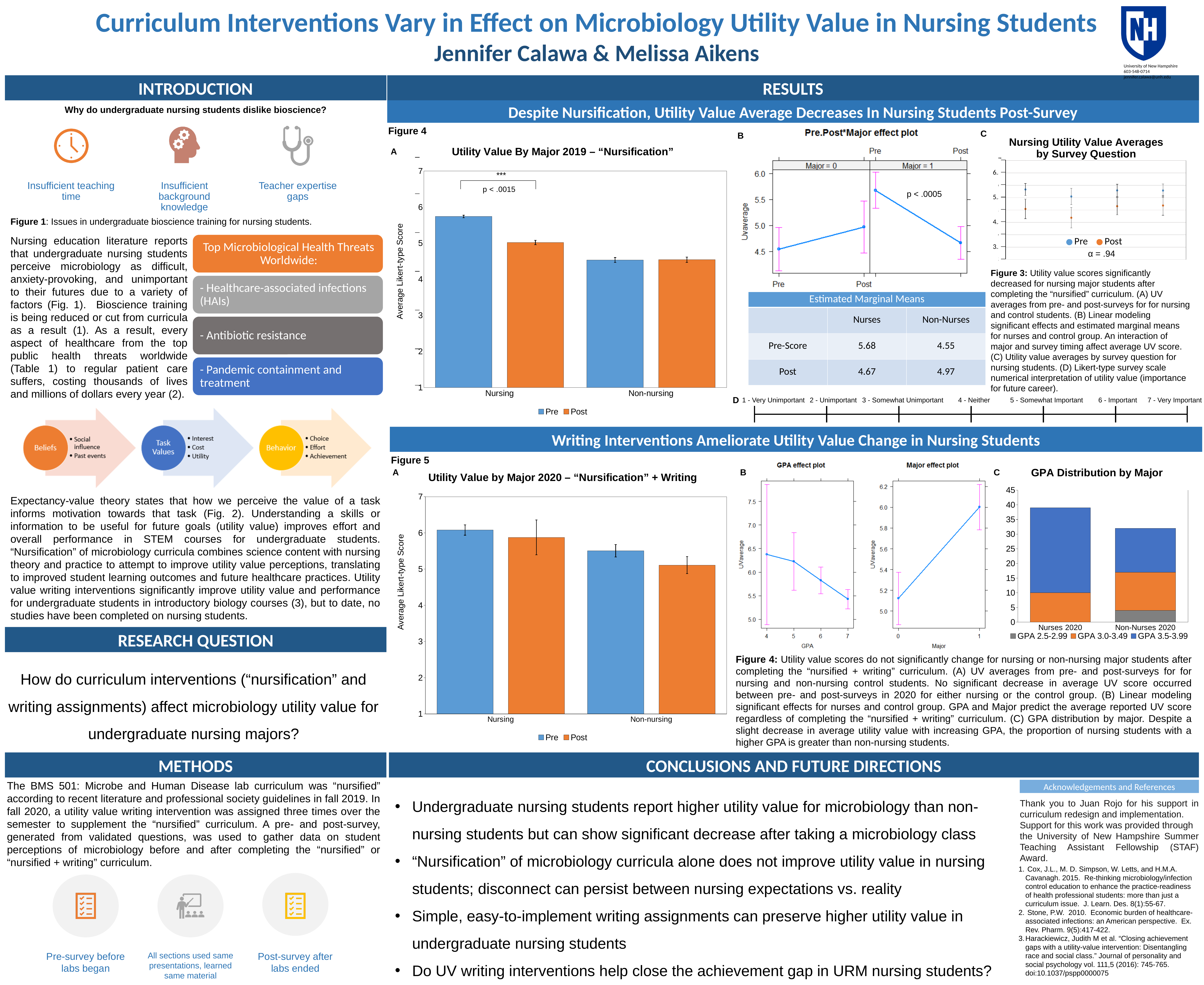
In the "Utility Value by Major 2020 – "Nursification" + Writing" chart, is the Pre value for Non-nursing greater or less than 5? greater In the "Utility Value by Major 2020 – "Nursification" + Writing" chart, which major has the higher Pre bar? Nursing In the "Utility Value By Major 2019 – "Nursification"" chart, is the Pre value for Nursing greater or less than 5? greater In the "Pre.Post*Major effect plot", does the line for Major = 1 rise or fall from Pre to Post? fall In the "Utility Value by Major 2020 – "Nursification" + Writing" chart, how many major categories are shown on the x axis? 2 In the "Utility Value By Major 2019 – "Nursification"" chart, which is larger for Nursing, the Pre bar or the Post bar? Pre In the "GPA Distribution by Major" chart, which category has the taller stacked bar? Nurses 2020 In the "Utility Value By Major 2019 – "Nursification"" chart, how many series does the legend list? 2 In the "GPA Distribution by Major" chart, how many GPA bands does the legend list? 3 What kind of chart is "Utility Value By Major 2019 – "Nursification""? bar chart In the "GPA Distribution by Major" chart, is the total for Non-Nurses 2020 greater or less than 35? less